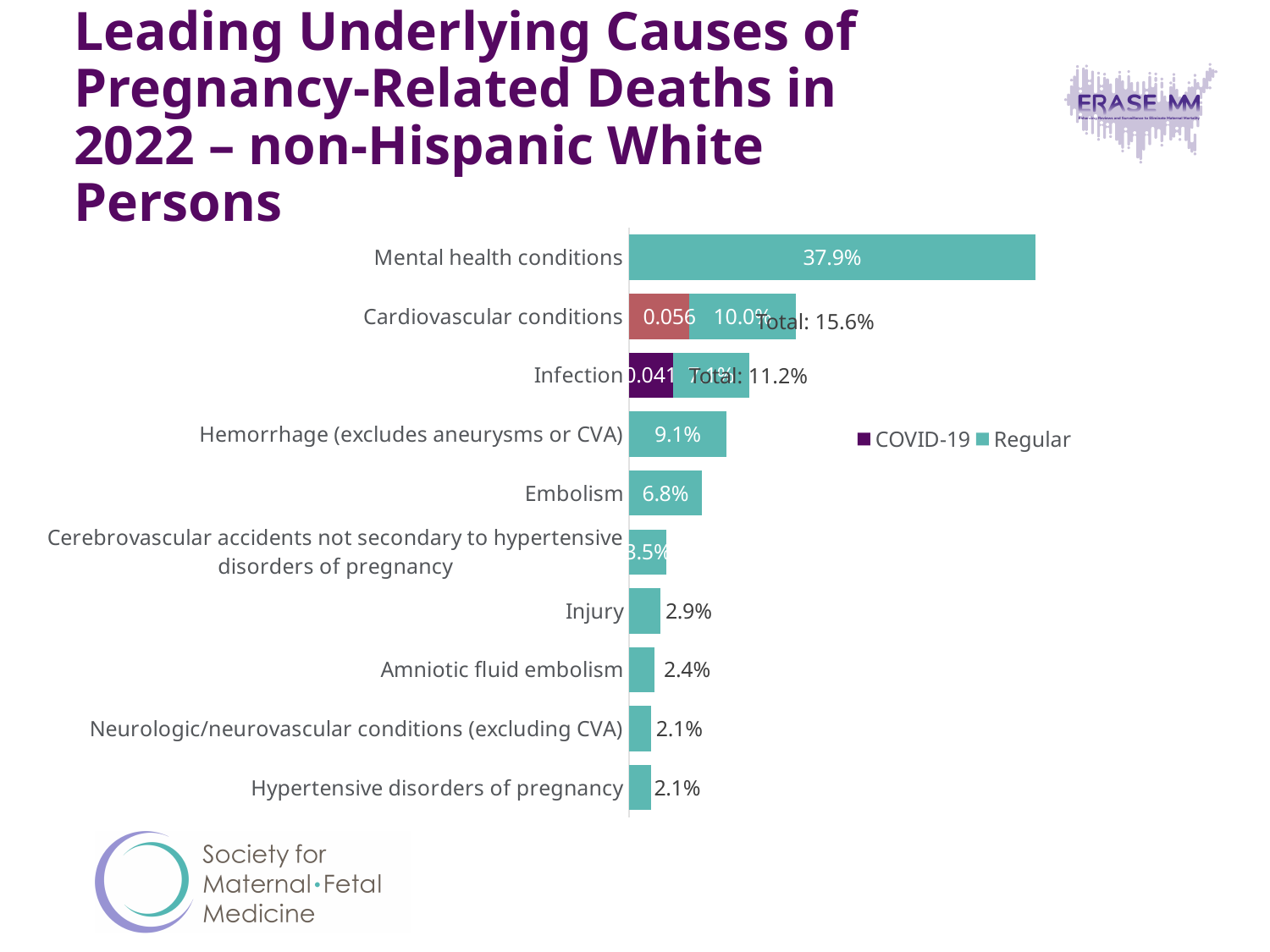
What percentage is shown for Amniotic fluid embolism? 2.4% What is the total percentage shown for Cardiovascular conditions? 15.6% Which cause has the highest percentage on the chart? Mental health conditions How many causes of death are listed on the chart? 10 What is the total percentage shown for Infection? 11.2% What are the two series named in the legend? COVID-19 and Regular What percentage is shown for Hemorrhage (excludes aneurysms or CVA)? 9.1% What percentage is shown for Embolism? 6.8% How many series does the legend list? 2 What percentage is shown for Injury? 2.9% What kind of chart is shown on the slide? Bar chart What percentage is shown for Mental health conditions? 37.9%